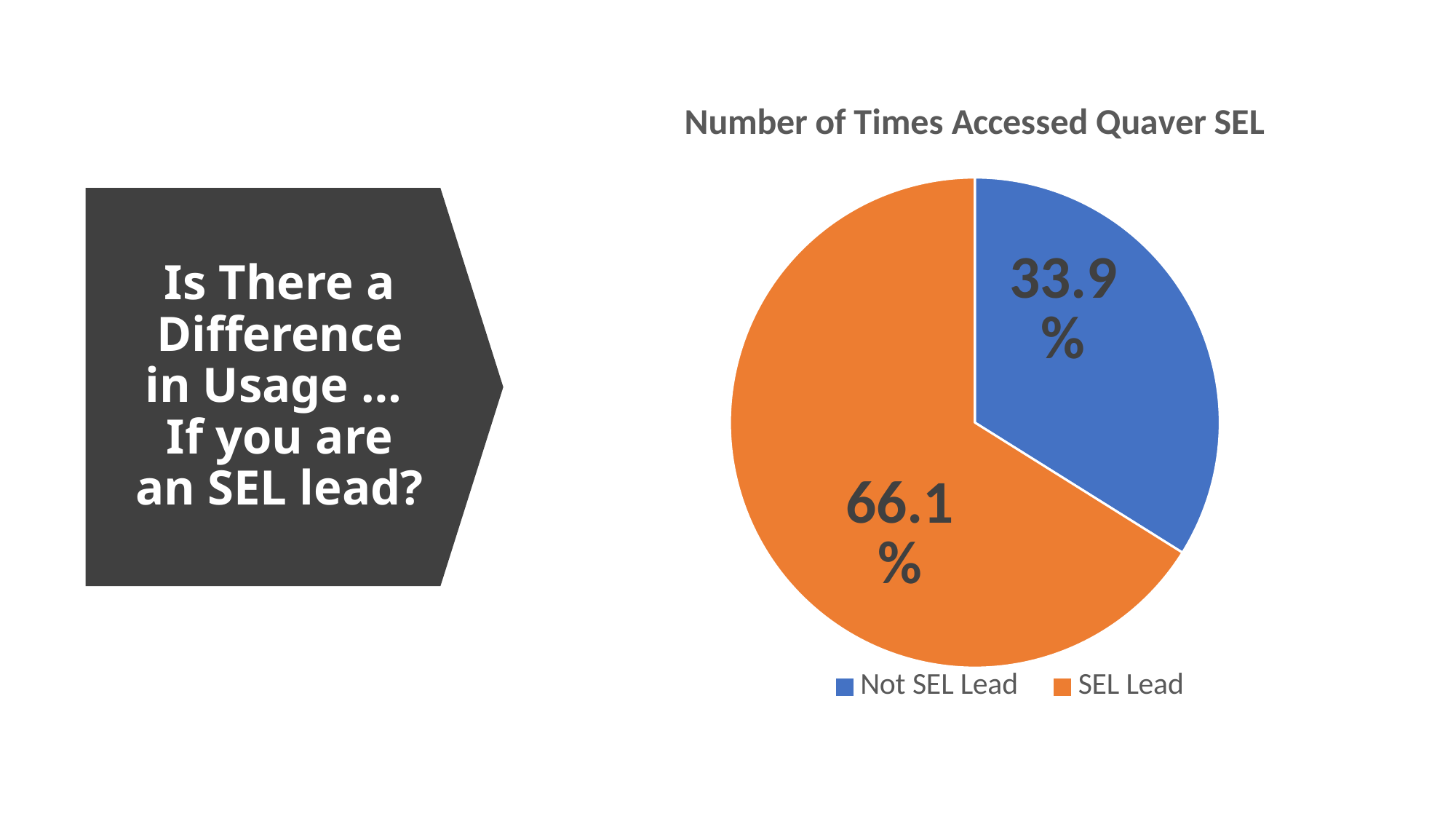
Which is larger, the SEL Lead slice or the Not SEL Lead slice? SEL Lead Which category has the largest slice of the pie? SEL Lead What is the difference in percentage points between the SEL Lead and Not SEL Lead slices? 32.2 What share of the pie does SEL Lead account for? 66.1% How many slices does the pie chart have? 2 What share of the pie does Not SEL Lead account for? 33.9% What type of chart is shown on the slide? pie chart How many entries does the legend list? 2 What is the title of the chart? Number of Times Accessed Quaver SEL Which category has the smallest slice of the pie? Not SEL Lead What colour is the SEL Lead slice? orange